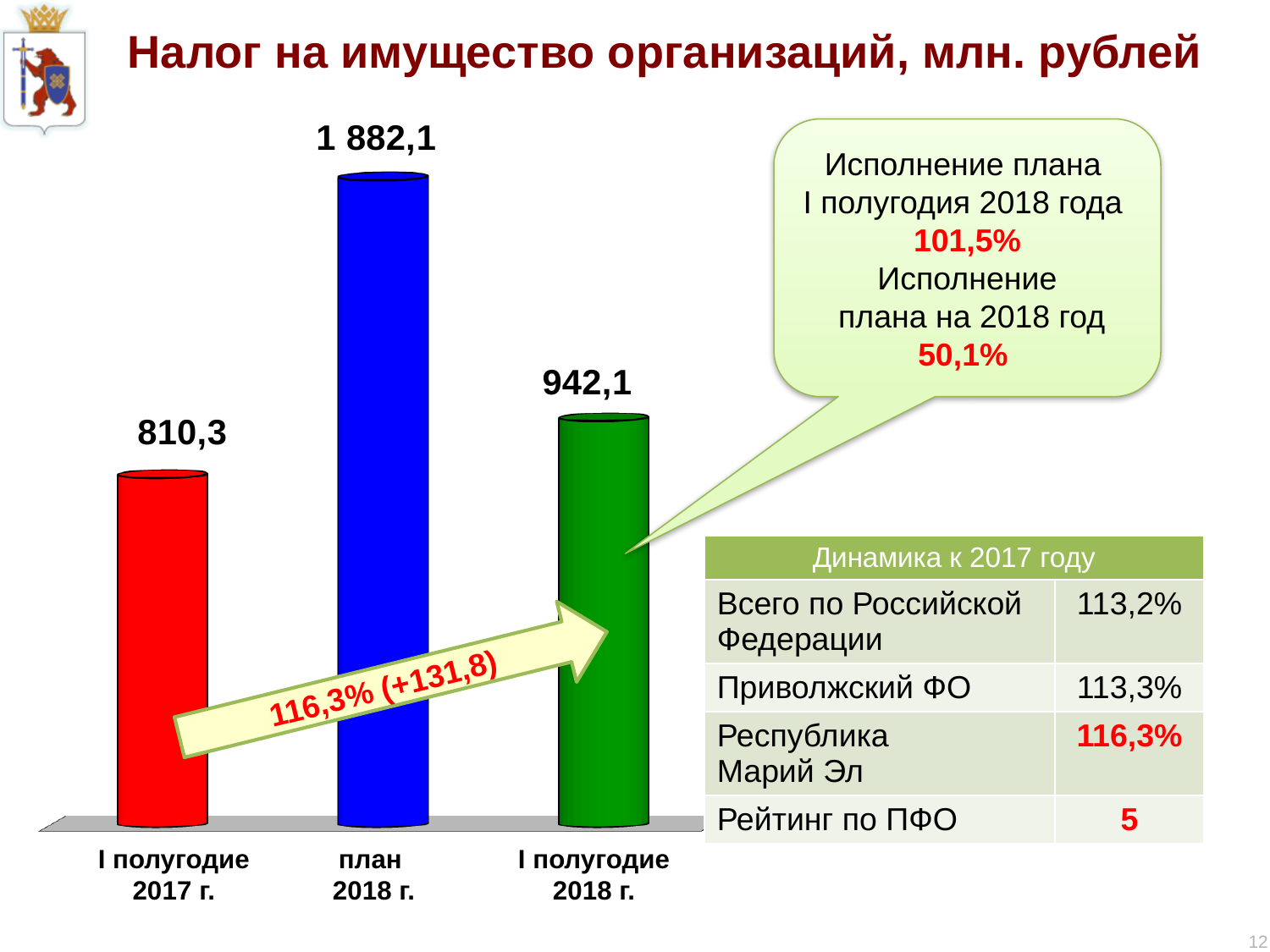
What is the value for I полугодие 2018 г.? 942,1 Which category has the lowest value? I полугодие 2017 г. What kind of chart is shown on the slide? bar chart What is the difference between the values for план 2018 г. and I полугодие 2018 г.? 940,0 What colour is the bar for план 2018 г.? blue How many bars are shown in the chart? 3 What is the value for I полугодие 2017 г.? 810,3 Which is larger, the value for I полугодие 2018 г. or the value for I полугодие 2017 г.? I полугодие 2018 г. What is the difference between the values for I полугодие 2018 г. and I полугодие 2017 г.? 131,8 Which category has the highest value? план 2018 г. What is the title of the chart? Налог на имущество организаций, млн. рублей What is the value for план 2018 г.? 1 882,1